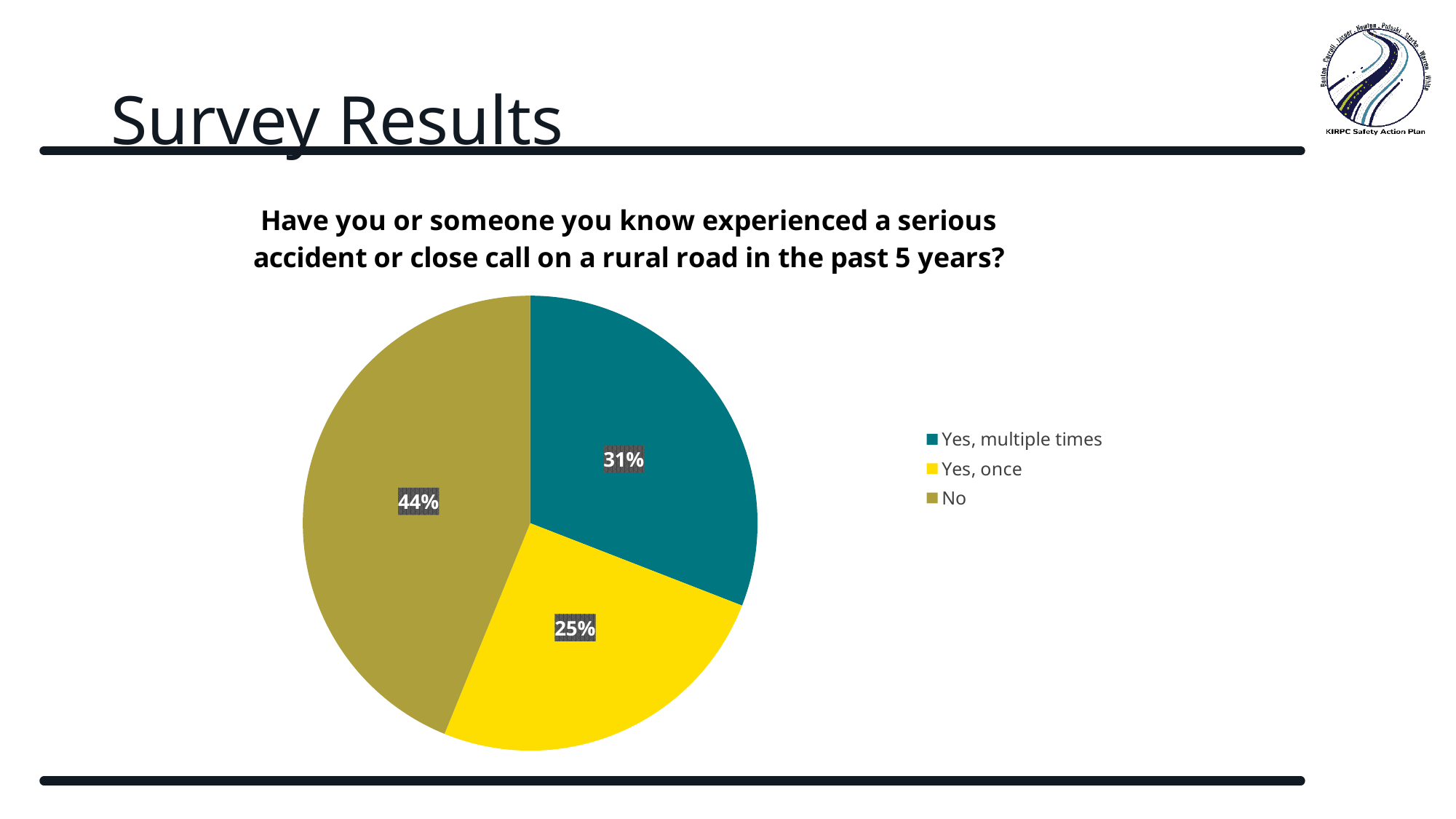
What is the difference in percentage points between "Yes, multiple times" and "Yes, once"? 6 How many categories does the pie chart have? 3 What percentage of respondents answered "Yes, once"? 25% What percentage of respondents answered "No"? 44% Which is larger: the share for "Yes, multiple times" or the share for "Yes, once"? Yes, multiple times Which response has the largest share of the pie? No What kind of chart is shown on the slide? Pie chart What colour is the "Yes, once" slice? Yellow What is the title of the chart? Have you or someone you know experienced a serious accident or close call on a rural road in the past 5 years? What is the difference in percentage points between "No" and "Yes, once"? 19 What percentage of respondents answered "Yes, multiple times"? 31% Which response has the smallest share of the pie? Yes, once